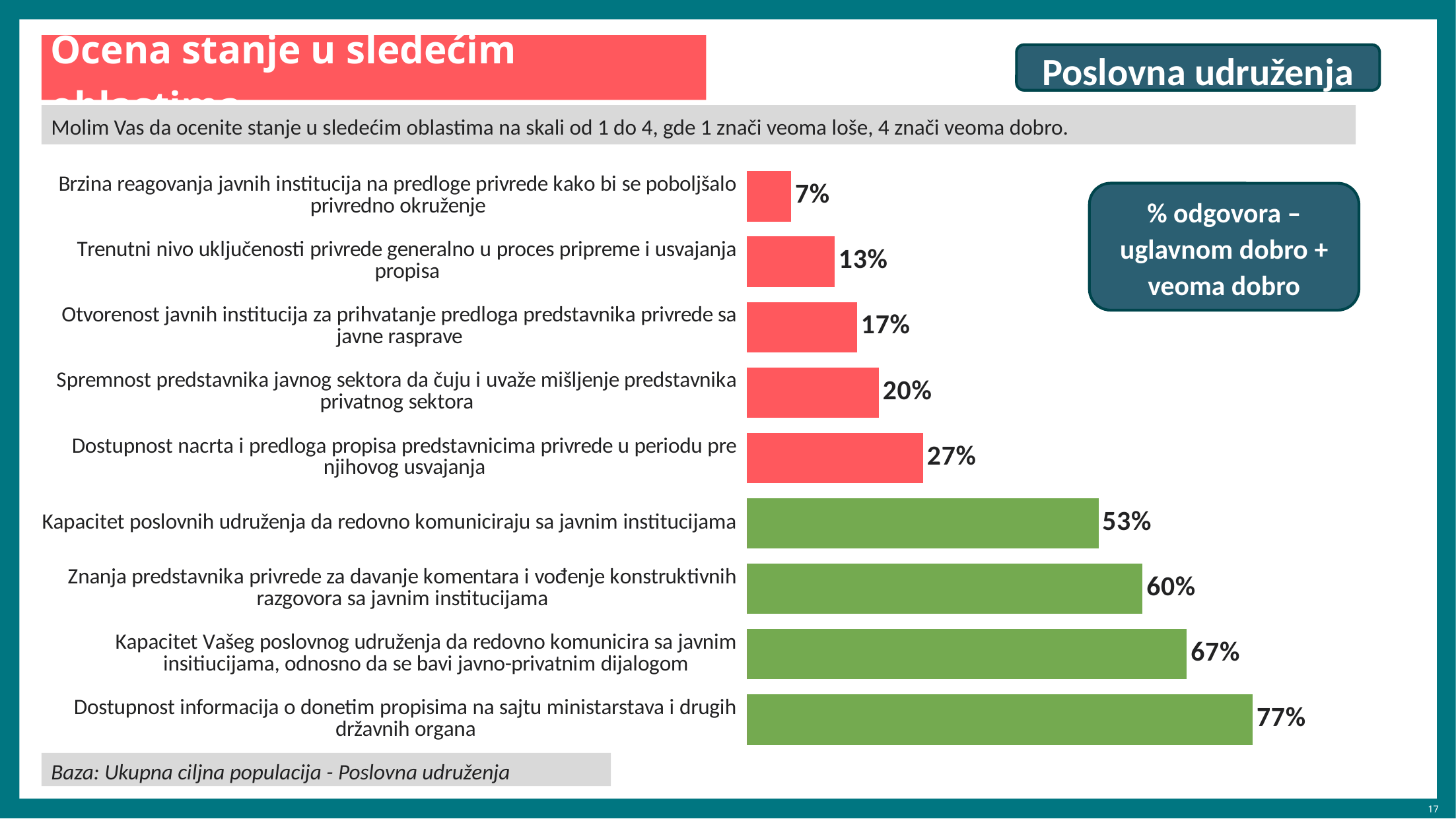
Which is larger: the value for "Trenutni nivo uključenosti privrede generalno u proces pripreme i usvajanja propisa" or the value for "Otvorenost javnih institucija za prihvatanje predloga predstavnika privrede sa javne rasprave"? Otvorenost javnih institucija za prihvatanje predloga predstavnika privrede sa javne rasprave What percentage is shown for "Kapacitet poslovnih udruženja da redovno komuniciraju sa javnim institucijama"? 53% How many categories are shown on the chart? 9 What is the difference between the value for "Kapacitet Vašeg poslovnog udruženja da redovno komunicira sa javnim insitiucijama, odnosno da se bavi javno-privatnim dijalogom" and the value for "Kapacitet poslovnih udruženja da redovno komuniciraju sa javnim institucijama"? 14% Which category has the lowest value on the chart? Brzina reagovanja javnih institucija na predloge privrede kako bi se poboljšalo privredno okruženje What percentage is shown for "Spremnost predstavnika javnog sektora da čuju i uvaže mišljenje predstavnika privatnog sektora"? 20% What is the difference between the value for "Dostupnost nacrta i predloga propisa predstavnicima privrede u periodu pre njihovog usvajanja" and the value for "Brzina reagovanja javnih institucija na predloge privrede kako bi se poboljšalo privredno okruženje"? 20% How many bars on the chart are coloured green? 4 What kind of chart is shown on the slide? Bar chart What percentage is shown for "Dostupnost informacija o donetim propisima na sajtu ministarstava i drugih državnih organa"? 77% According to the label on the right of the chart, what do the percentages represent? % odgovora – uglavnom dobro + veoma dobro Which category has the highest value on the chart? Dostupnost informacija o donetim propisima na sajtu ministarstava i drugih državnih organa